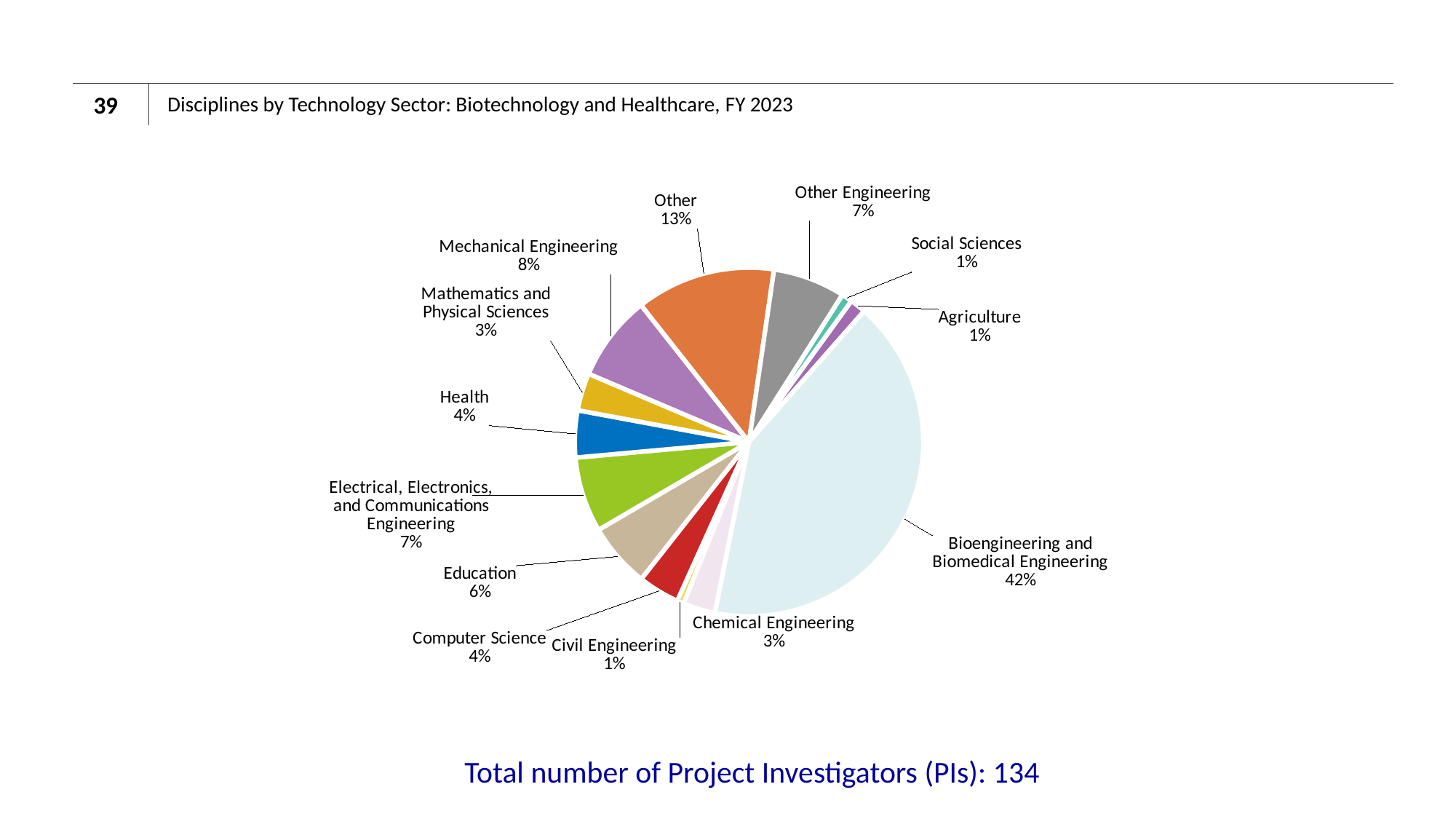
What is the title of the slide containing the chart? Disciplines by Technology Sector: Biotechnology and Healthcare, FY 2023 What is the difference in percentage points between Bioengineering and Biomedical Engineering and Other? 29 What percentage is shown for Other Engineering? 7% What total number of Project Investigators (PIs) is stated below the chart? 134 What share of the pie does Bioengineering and Biomedical Engineering hold? 42% What percentage is shown for Education? 6% What is the difference in percentage points between Other (13%) and Mechanical Engineering (8%)? 5 What kind of chart is shown on the slide? pie chart Which discipline has the largest slice of the pie? Bioengineering and Biomedical Engineering Which is larger, the share for Health or the share for Education? Education How many disciplines (slices) are shown in the pie chart? 13 What percentage is shown for Mechanical Engineering? 8%